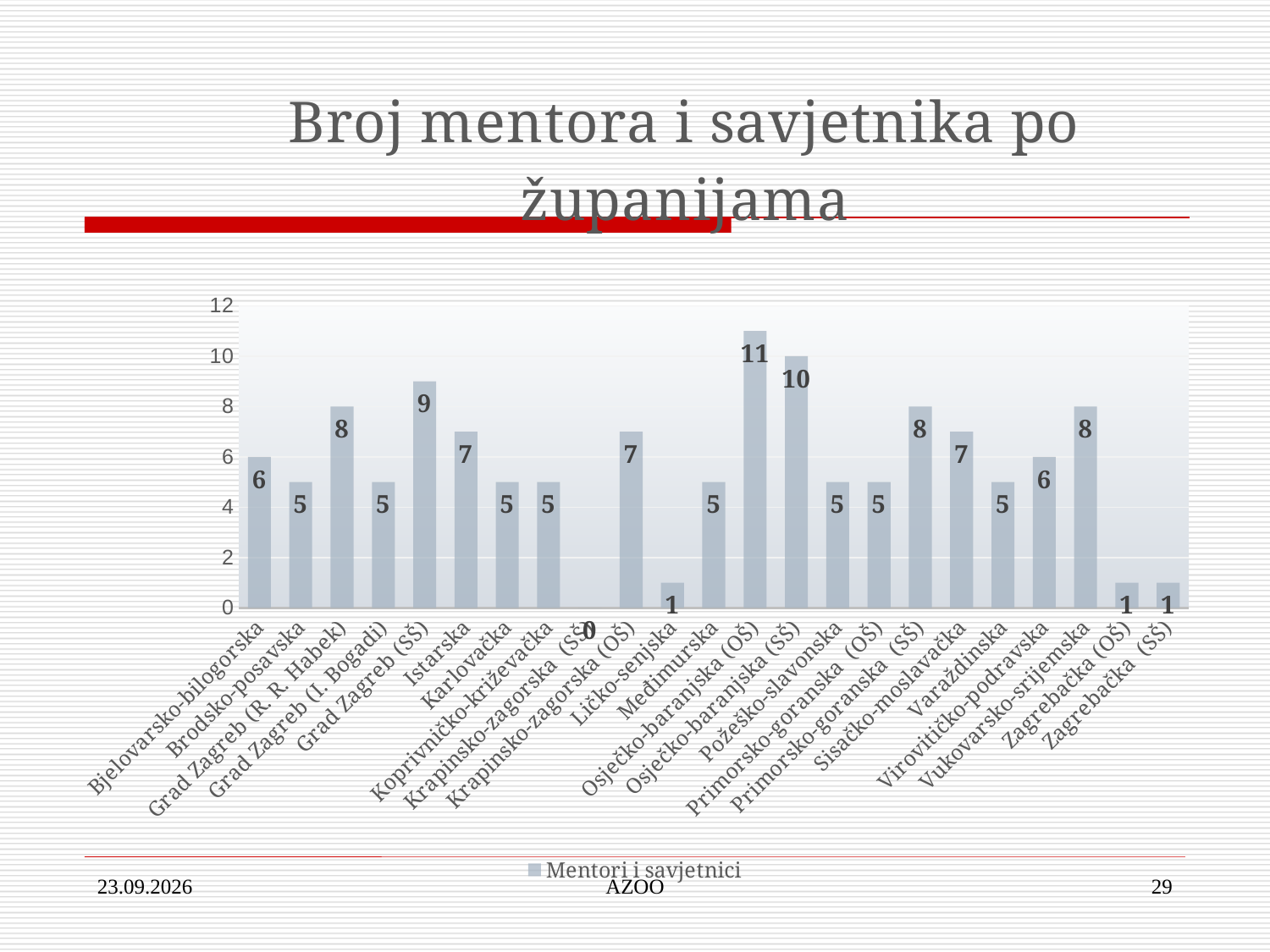
What is the difference between the values for Osječko-baranjska (OŠ) and Osječko-baranjska (SŠ)? 1 What is the difference between the values for Grad Zagreb (R. R. Habek) and Grad Zagreb (I. Bogadi)? 3 Which is larger, the value for Vukovarsko-srijemska or the value for Virovitičko-podravska? Vukovarsko-srijemska Which category has the lowest value? Krapinsko-zagorska (SŠ) What is the value for Osječko-baranjska (OŠ)? 11 How many categories are shown on the x axis? 23 What is the legend entry of the chart? Mentori i savjetnici Which category has the highest value? Osječko-baranjska (OŠ) What is the value for Grad Zagreb (SŠ)? 9 How many series does the legend list? 1 What is the value for Istarska? 7 What kind of chart is shown on the slide? Bar chart